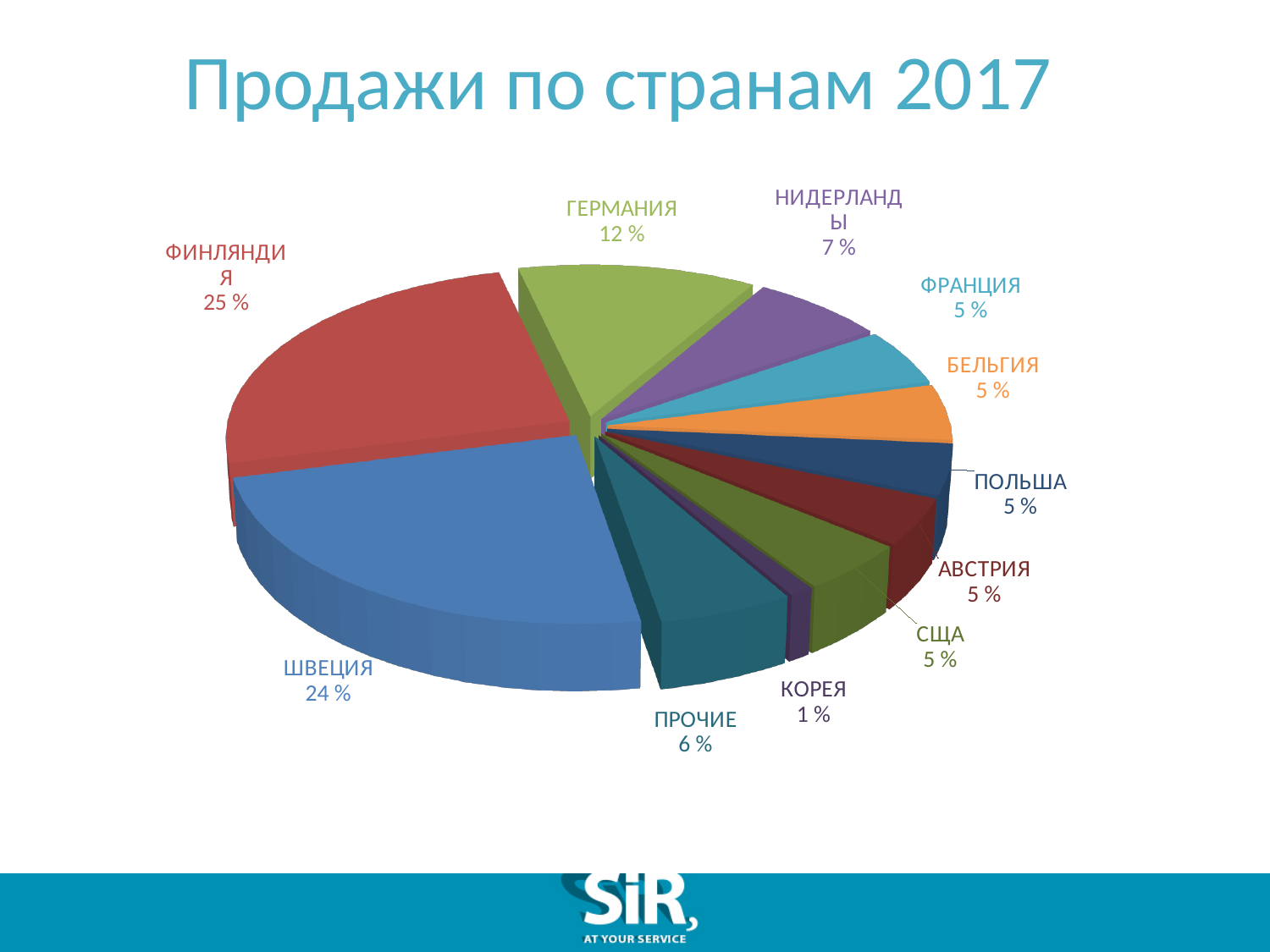
What share of sales does Финляндия have? 25 % Which country has the smallest share of sales? Корея What is the title of the chart? Продажи по странам 2017 What share of sales does Корея have? 1 % Which country has the largest share of sales? Финляндия What share of sales does Германия have? 12 % What is the difference in share between Финляндия and Германия? 13 % What share of sales does Нидерланды have? 7 % What share of sales does Швеция have? 24 % How many slices does the pie chart have? 11 What kind of chart is shown on the slide? pie chart What share of sales does Прочие have? 6 %